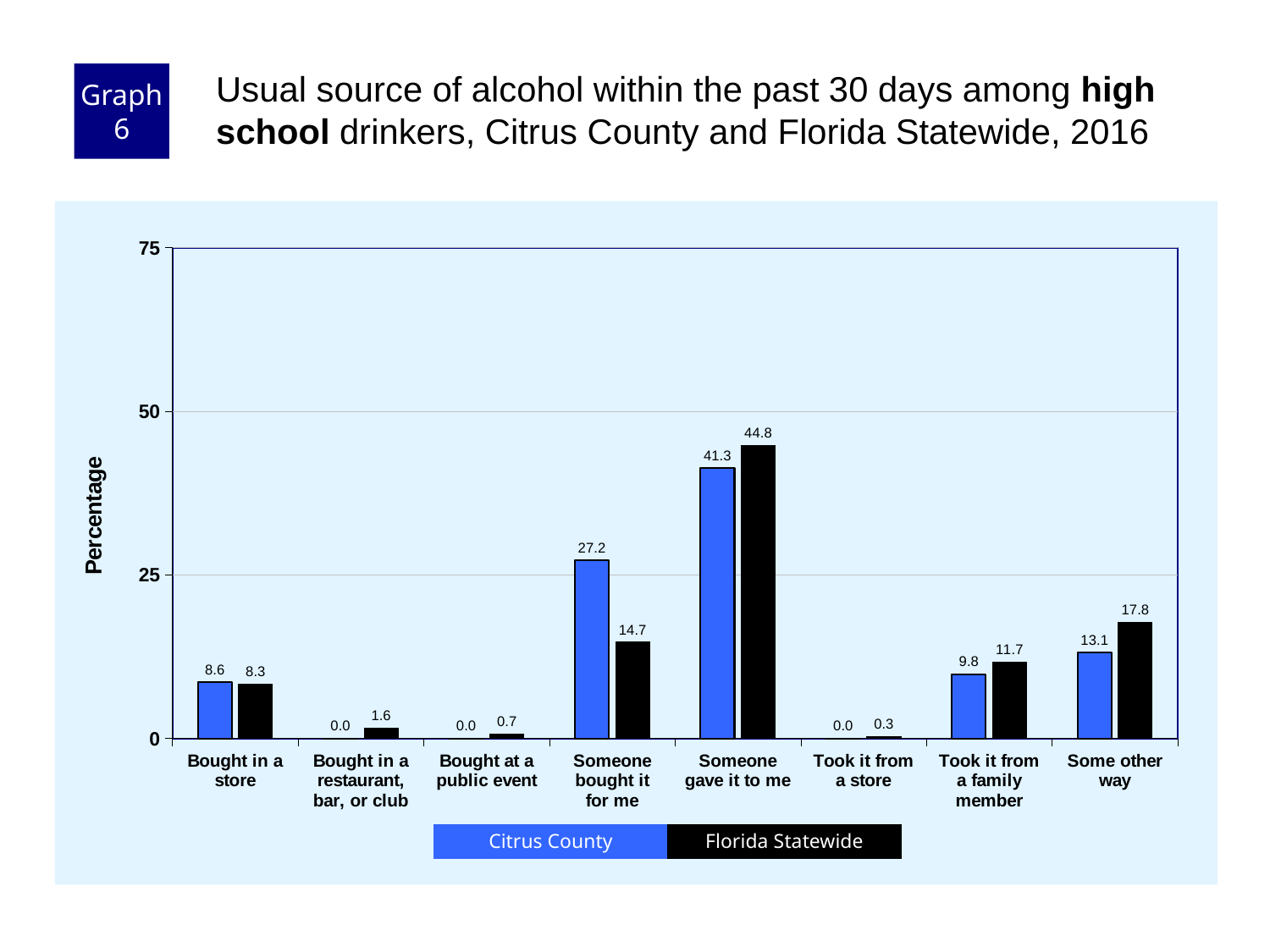
How many series does the legend list? 2 What is the Citrus County value for "Someone bought it for me"? 27.2 Is the Citrus County value for "Someone gave it to me" greater or less than 50? less Which is larger for "Some other way": the Citrus County value or the Florida Statewide value? Florida Statewide What colour are the Florida Statewide bars? black Which category has the highest Citrus County value? Someone gave it to me What is the Florida Statewide value for "Took it from a store"? 0.3 What kind of chart is shown on the slide? bar chart What is the difference between the Citrus County and Florida Statewide values for "Someone bought it for me"? 12.5 What is the Florida Statewide value for "Someone gave it to me"? 44.8 Which category has the lowest Florida Statewide value? Took it from a store How many categories are shown on the x axis? 8